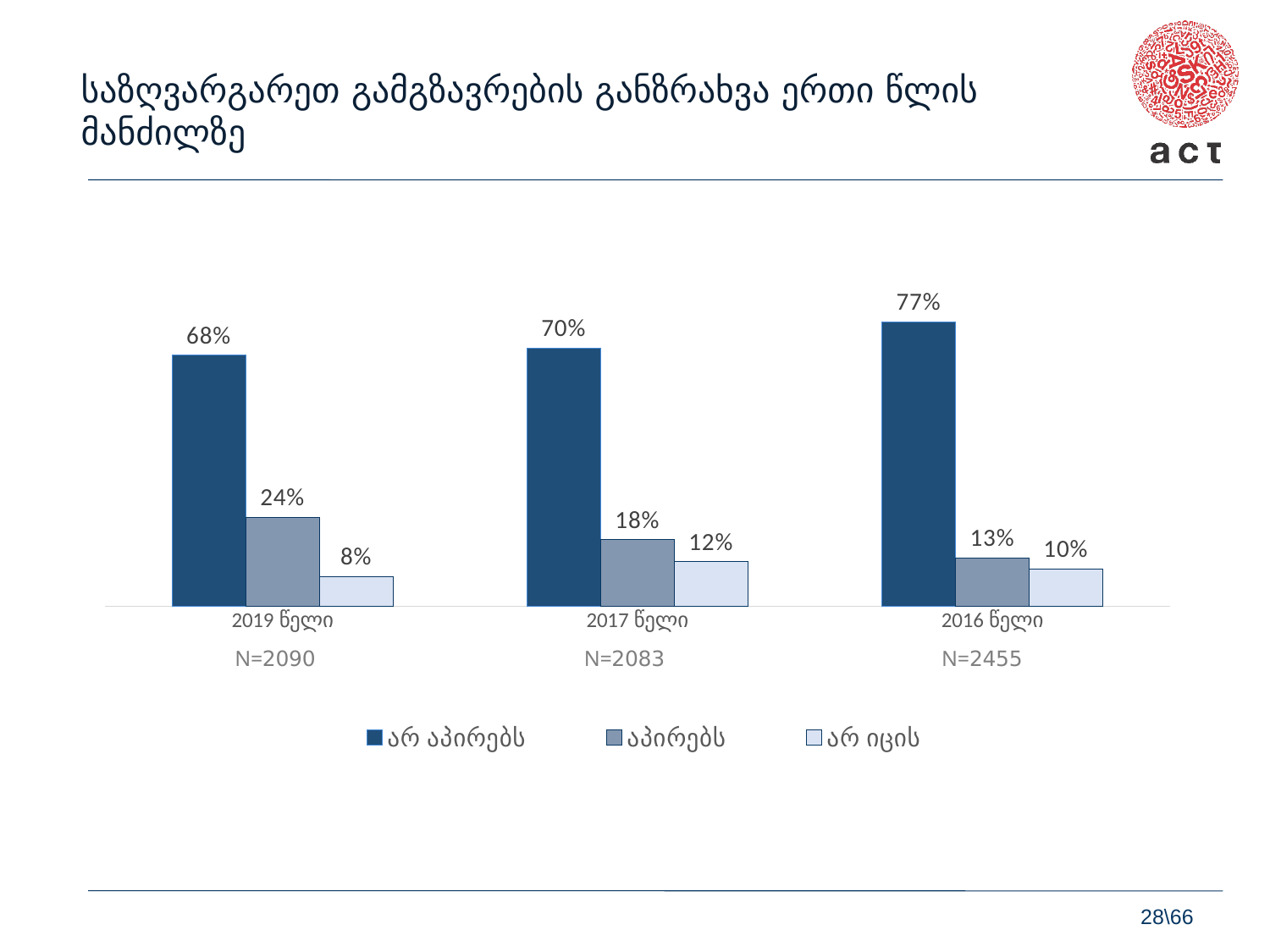
In which year is the "არ აპირებს" value highest? 2016 წელი What is the value of the "აპირებს" series for 2017 წელი? 18% What is the value of the "არ აპირებს" series for 2019 წელი? 68% Which is larger: the "არ იცის" value for 2017 წელი or for 2019 წელი? 2017 წელი What is the value of the "არ იცის" series for 2016 წელი? 10% What kind of chart is shown on the slide? Bar chart In which year is the "აპირებს" value lowest? 2016 წელი How many series does the legend list? 3 What is the difference between the "არ აპირებს" values for 2016 წელი and 2019 წელი? 9% How many year categories are shown on the x axis? 3 Which legend entry is shown with the darkest blue colour? არ აპირებს What is the sample size (N) shown for 2017 წელი? N=2083